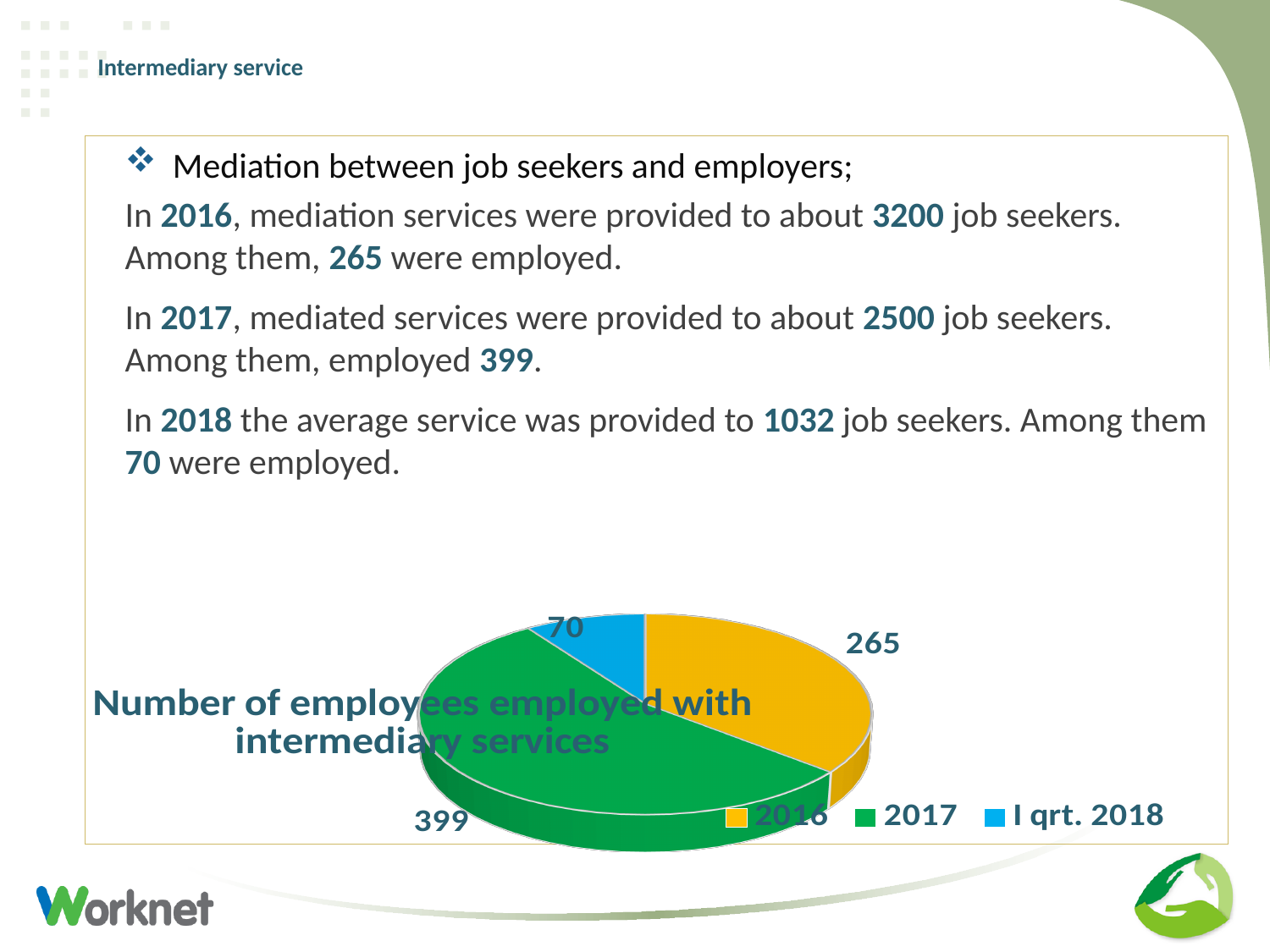
How many slices does the pie chart have? 3 What is the chart's title? Number of employees employed with intermediary services What colour is the slice for 2017? green What is the value for 2017 in the pie chart? 399 Which category has the smallest slice in the pie chart? I qrt. 2018 Which is larger, the value for 2016 or the value for I qrt. 2018? 2016 How many entries does the legend list? 3 What is the difference between the values for 2017 and 2016? 134 What is the value for 2016 in the pie chart? 265 Which category has the largest slice in the pie chart? 2017 What kind of chart is shown on the slide? pie chart What is the value for I qrt. 2018 in the pie chart? 70